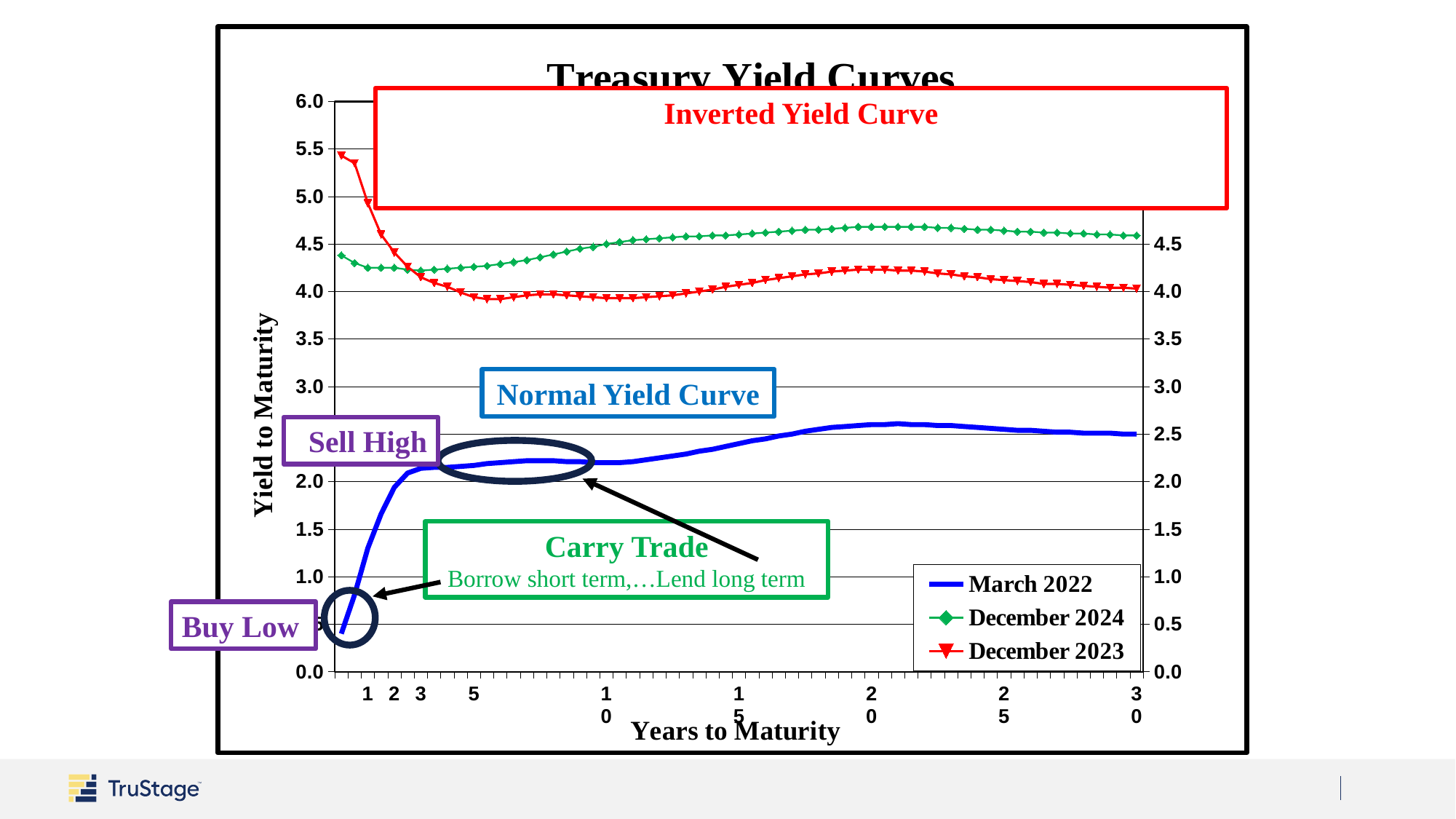
Which series has the lowest yields across the whole range of maturities? March 2022 Does the December 2023 curve rise or fall between 1 and 5 years to maturity? Fall Is the December 2024 value at 1 year to maturity greater or less than 4.0? greater At 30 years to maturity, which series is higher: December 2023 or December 2024? December 2024 Is the March 2022 value at 1 year to maturity greater or less than 1.5? less Is the March 2022 value at 10 years to maturity greater or less than 2.0? greater At 1 year to maturity, which series is higher: December 2023 or December 2024? December 2023 How many series does the legend list? 3 What kind of chart is shown on the slide? Line chart What is the title of the chart? Treasury Yield Curves What is the label of the x axis? Years to Maturity